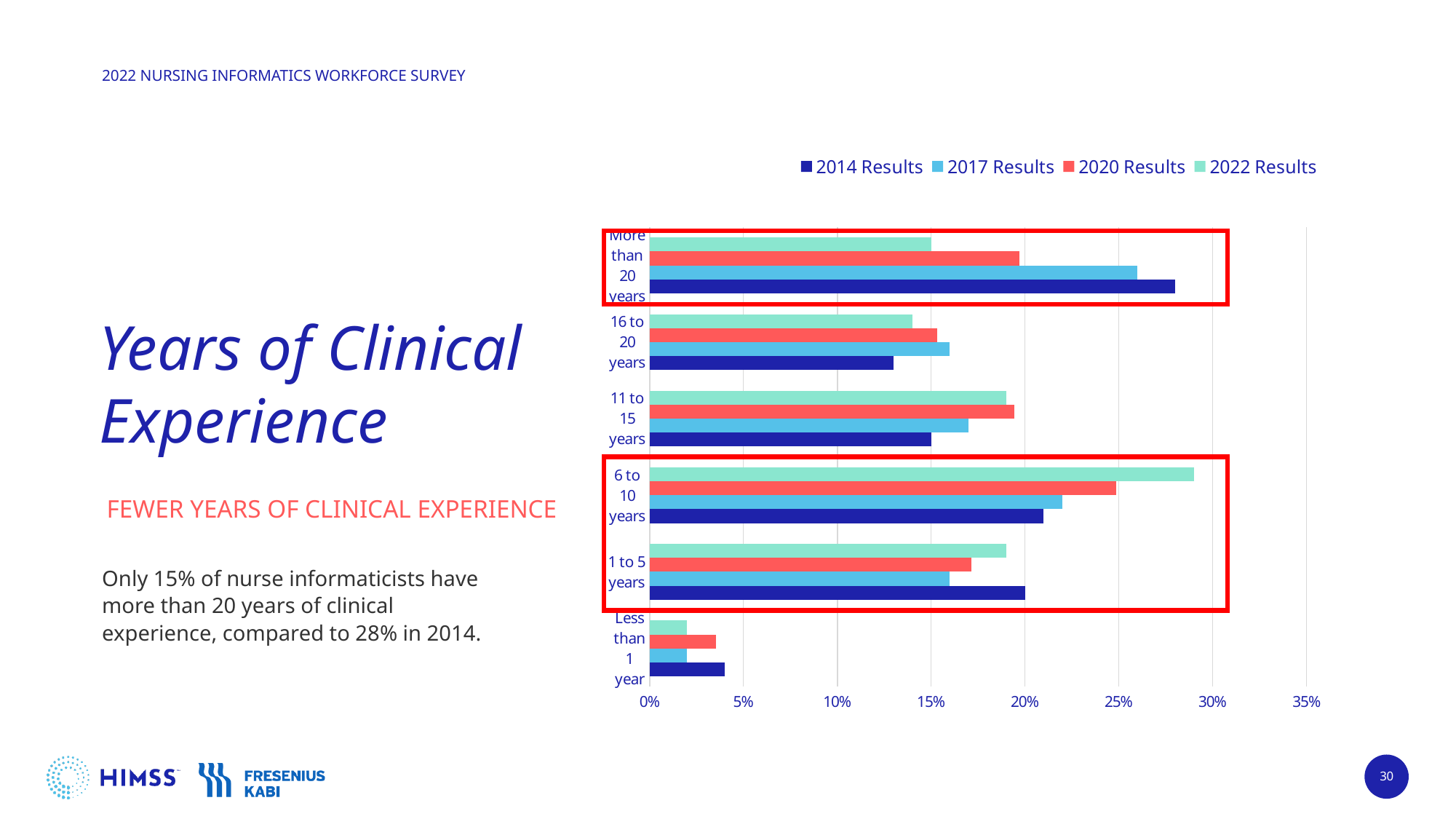
How many series does the legend list? 4 Which series has the highest value for '6 to 10 years'? 2022 Results What kind of chart is shown on the slide? bar chart Is the 2022 Results value for '6 to 10 years' greater or less than 25%? greater Which is larger for '1 to 5 years': the 2014 Results value or the 2017 Results value? 2014 Results For the 2022 Results series, which category has the lowest value? Less than 1 year What is the 2014 Results value for 'More than 20 years'? 28% Which series has the highest value for 'More than 20 years'? 2014 Results For the 2022 Results series, which category has the highest value? 6 to 10 years How many experience categories are shown on the chart? 6 What is the 2022 Results value for 'More than 20 years'? 15% Is the 2014 Results value for 'Less than 1 year' greater or less than 5%? less